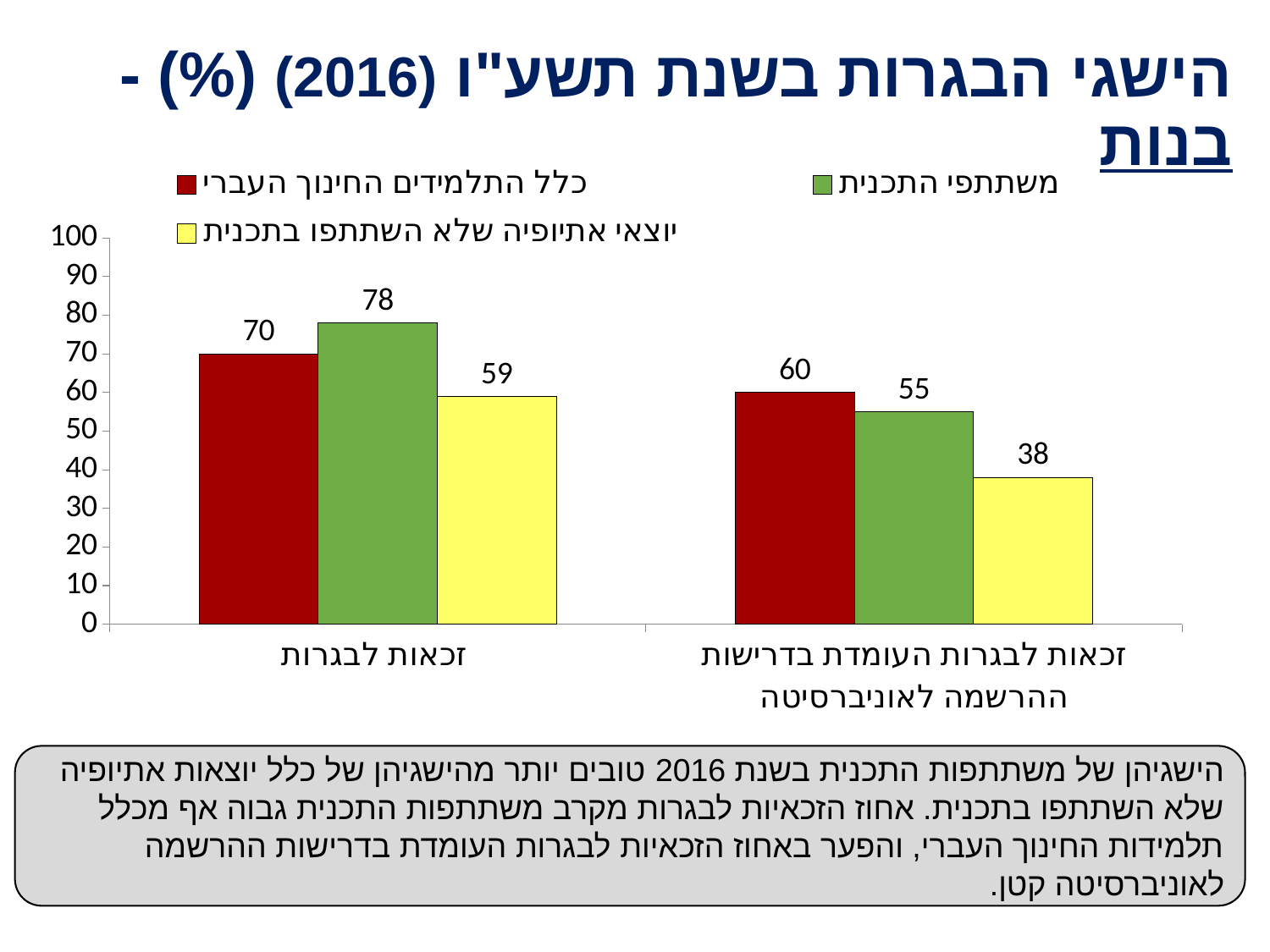
Which series has the highest value in the זכאות לבגרות category? משתתפי התכנית What is the value for משתתפי התכנית in the זכאות לבגרות העומדת בדרישות ההרשמה לאוניברסיטה category? 55 What is the value for משתתפי התכנית in the זכאות לבגרות category? 78 What is the difference between משתתפי התכנית and יוצאי אתיופיה שלא השתתפו בתכנית in the זכאות לבגרות category? 19 In the זכאות לבגרות העומדת בדרישות ההרשמה לאוניברסיטה category, which is larger: כלל התלמידים החינוך העברי or משתתפי התכנית? כלל התלמידים החינוך העברי What kind of chart is shown on the slide? bar chart How many series does the legend list? 3 What is the value for כלל התלמידים החינוך העברי in the זכאות לבגרות category? 70 How many categories are shown on the x axis? 2 What is the difference between כלל התלמידים החינוך העברי and משתתפי התכנית in the זכאות לבגרות העומדת בדרישות ההרשמה לאוניברסיטה category? 5 Which series has the lowest value in the זכאות לבגרות העומדת בדרישות ההרשמה לאוניברסיטה category? יוצאי אתיופיה שלא השתתפו בתכנית What is the value for יוצאי אתיופיה שלא השתתפו בתכנית in the זכאות לבגרות העומדת בדרישות ההרשמה לאוניברסיטה category? 38